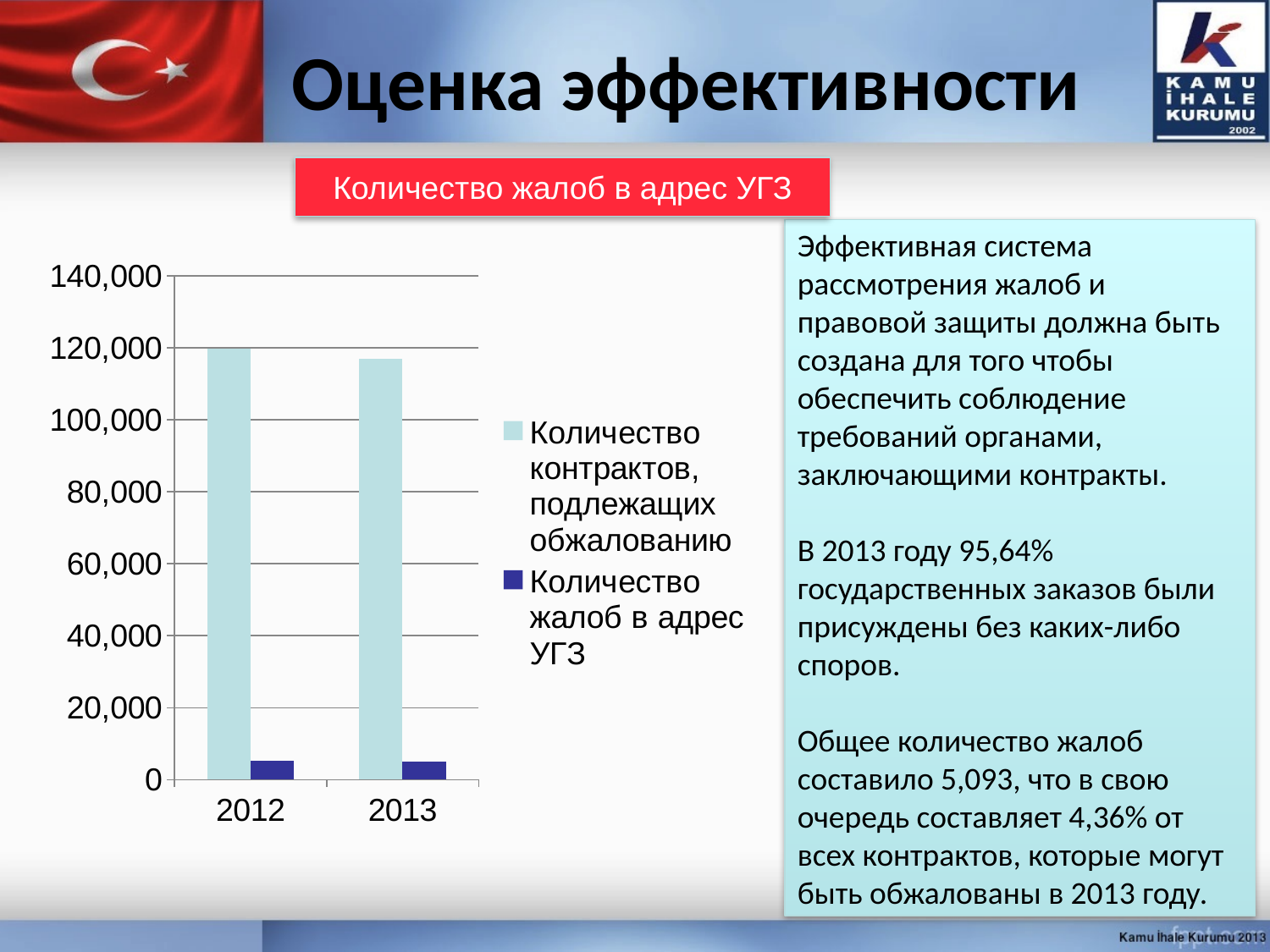
What is the title shown above the chart? Количество жалоб в адрес УГЗ What is the highest value shown on the y axis of the chart? 140,000 How many years (categories) are shown on the x axis of the chart? 2 Is the value for 'Количество контрактов, подлежащих обжалованию' in 2013 greater or less than 120,000? less How many series does the chart legend list? 2 Is the value for 'Количество контрактов, подлежащих обжалованию' in 2012 greater or less than 100,000? greater Which series is shown in dark blue in the chart? Количество жалоб в адрес УГЗ Which series has the higher values in the chart, 'Количество контрактов, подлежащих обжалованию' or 'Количество жалоб в адрес УГЗ'? Количество контрактов, подлежащих обжалованию What kind of chart is shown on the slide? bar chart Which year has the higher value for 'Количество контрактов, подлежащих обжалованию', 2012 or 2013? 2012 Is the value for 'Количество жалоб в адрес УГЗ' in 2012 greater or less than 40,000? less